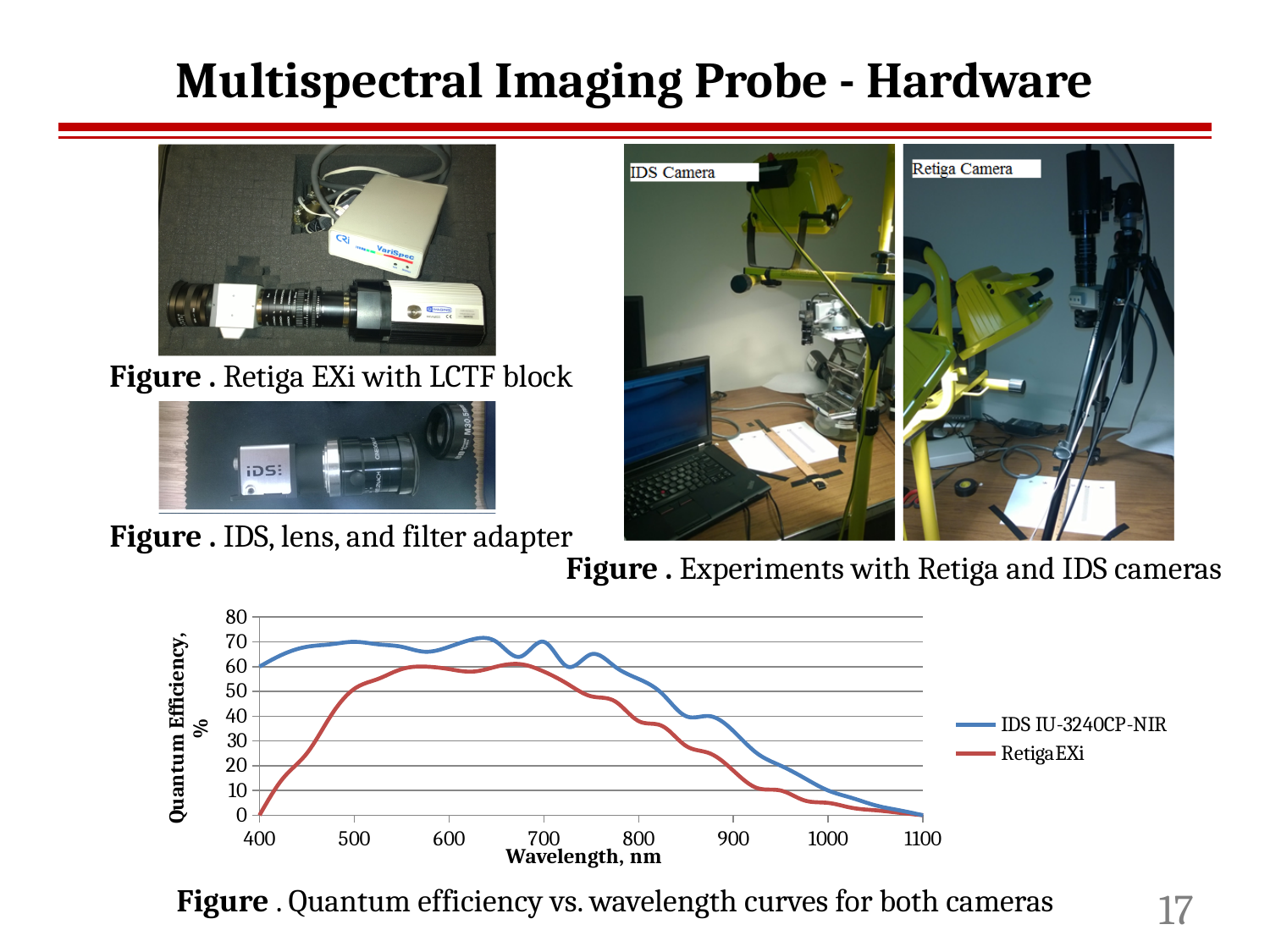
What are the two series named in the legend of the quantum efficiency chart? IDS IU-3240CP-NIR and Retiga EXi How many series does the legend of the quantum efficiency chart list? 2 In the quantum efficiency chart, is the value for IDS IU-3240CP-NIR at 600 nm greater or less than 60? greater What is the label of the x axis of the quantum efficiency chart? Wavelength, nm In the quantum efficiency chart, which series has the higher value at 800 nm, IDS IU-3240CP-NIR or Retiga EXi? IDS IU-3240CP-NIR In the quantum efficiency chart, does the IDS IU-3240CP-NIR curve rise or fall between 800 nm and 1100 nm? fall What kind of chart is shown at the bottom of the slide? line chart In the quantum efficiency chart, is the value for Retiga EXi at 1000 nm greater or less than 10? less In the quantum efficiency chart, does the Retiga EXi curve rise or fall between 400 nm and 500 nm? rise In the quantum efficiency chart, which series reaches the higher peak quantum efficiency? IDS IU-3240CP-NIR